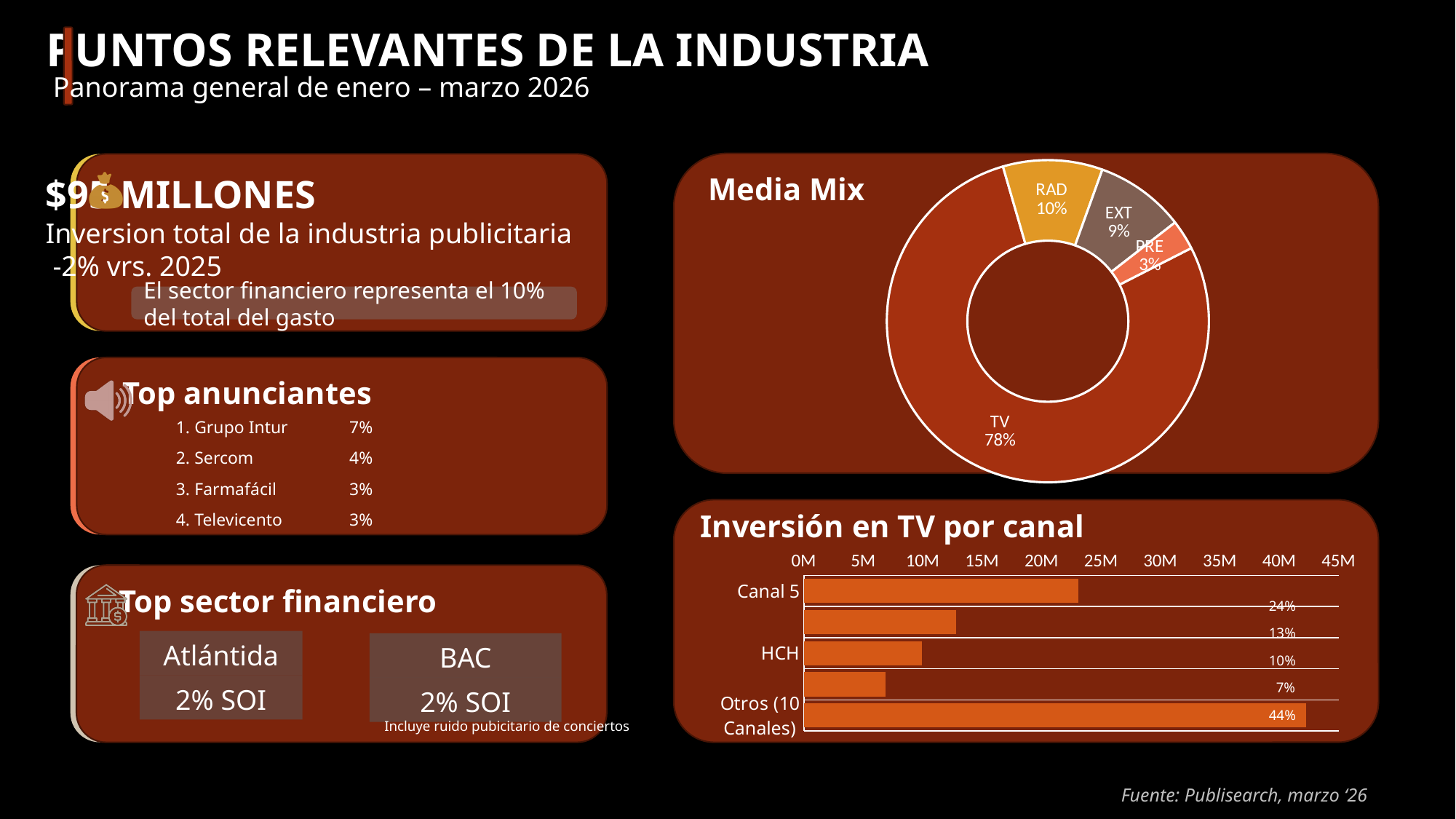
In the Media Mix chart, what share does TV have? 78% In the 'Inversión en TV por canal' chart, which of Canal 5 or HCH has the larger value? Canal 5 What kind of chart is 'Inversión en TV por canal'? Bar chart In the Media Mix chart, which medium has the largest share? TV In the 'Inversión en TV por canal' chart, what percentage label is shown for Canal 5? 24% In the Media Mix chart, what is the difference between the TV share and the RAD share? 68% What kind of chart is the Media Mix chart? Doughnut chart In the Media Mix chart, what share does RAD have? 10% In the Media Mix chart, how many slices are there? 4 In the Media Mix chart, which medium has the smallest share? PRE In the 'Inversión en TV por canal' chart, is the value for Canal 5 greater or less than 20M? greater In the 'Inversión en TV por canal' chart, what percentage label is shown for Otros (10 Canales)? 44%